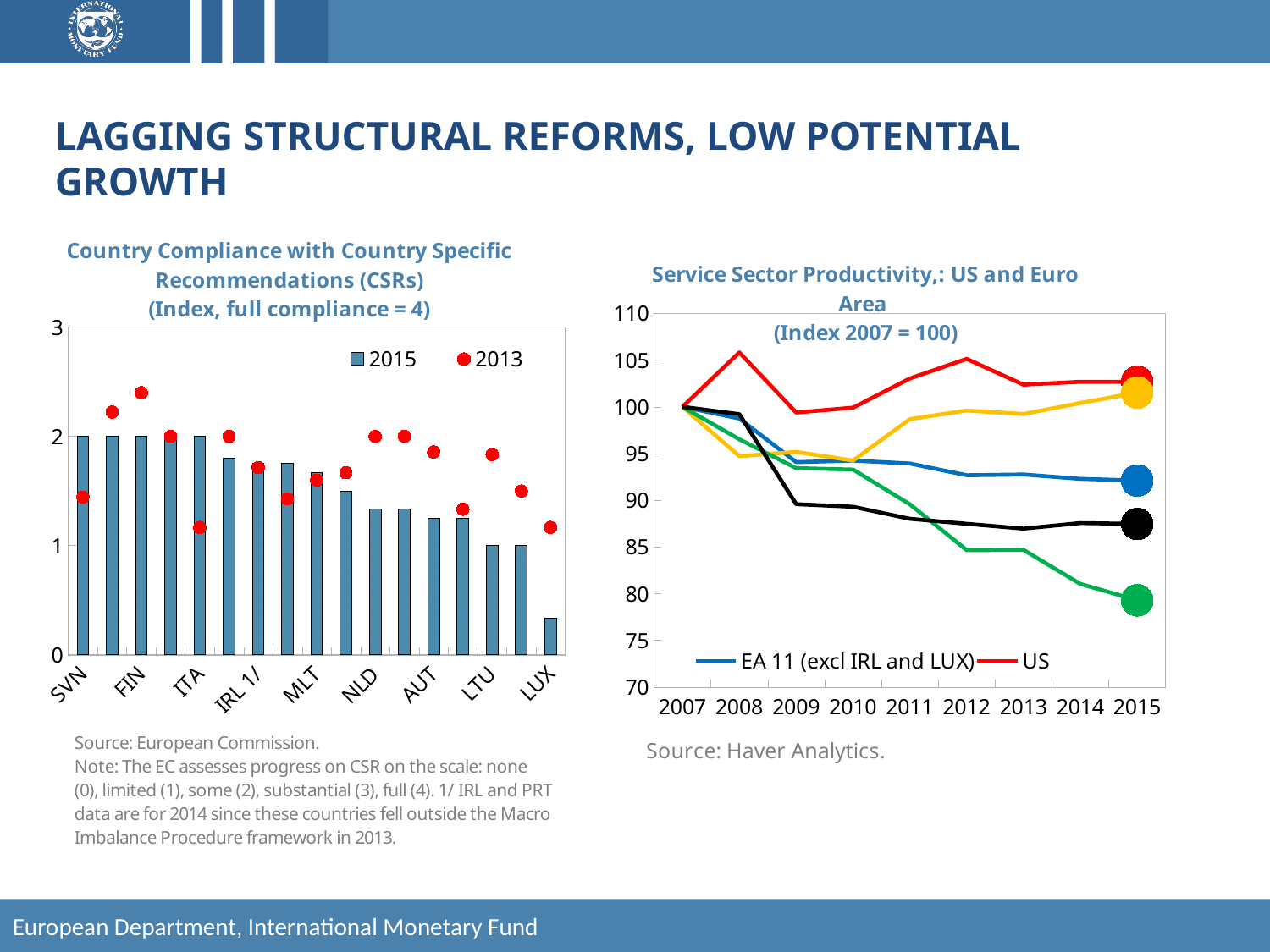
How many series does the legend of the 'Country Compliance with Country Specific Recommendations (CSRs)' chart list? 2 In the 'Country Compliance with Country Specific Recommendations (CSRs)' chart, is the 2015 value for LUX greater or less than 1? less In the 'Country Compliance with Country Specific Recommendations (CSRs)' chart, which labelled country has the lowest 2015 bar? LUX What kind of chart is the 'Country Compliance with Country Specific Recommendations (CSRs)' chart on the left? bar chart What kind of chart is the 'Service Sector Productivity: US and Euro Area' chart on the right? line chart In the 'Service Sector Productivity: US and Euro Area' chart, does the EA 11 (excl IRL and LUX) line rise or fall from 2007 to 2015? fall In the 'Service Sector Productivity: US and Euro Area' chart, in 2015 which is higher: US or EA 11 (excl IRL and LUX)? US In the 'Country Compliance with Country Specific Recommendations (CSRs)' chart, for ITA, which is larger: the 2013 value or the 2015 value? 2015 In the 'Country Compliance with Country Specific Recommendations (CSRs)' chart, what is the 2015 value for SVN? 2 In the 'Service Sector Productivity: US and Euro Area' chart, how many years are shown on the x axis? 9 In the 'Country Compliance with Country Specific Recommendations (CSRs)' chart, for LTU, which is larger: the 2013 value or the 2015 value? 2013 In the 'Country Compliance with Country Specific Recommendations (CSRs)' chart, what is the 2015 value for LTU? 1